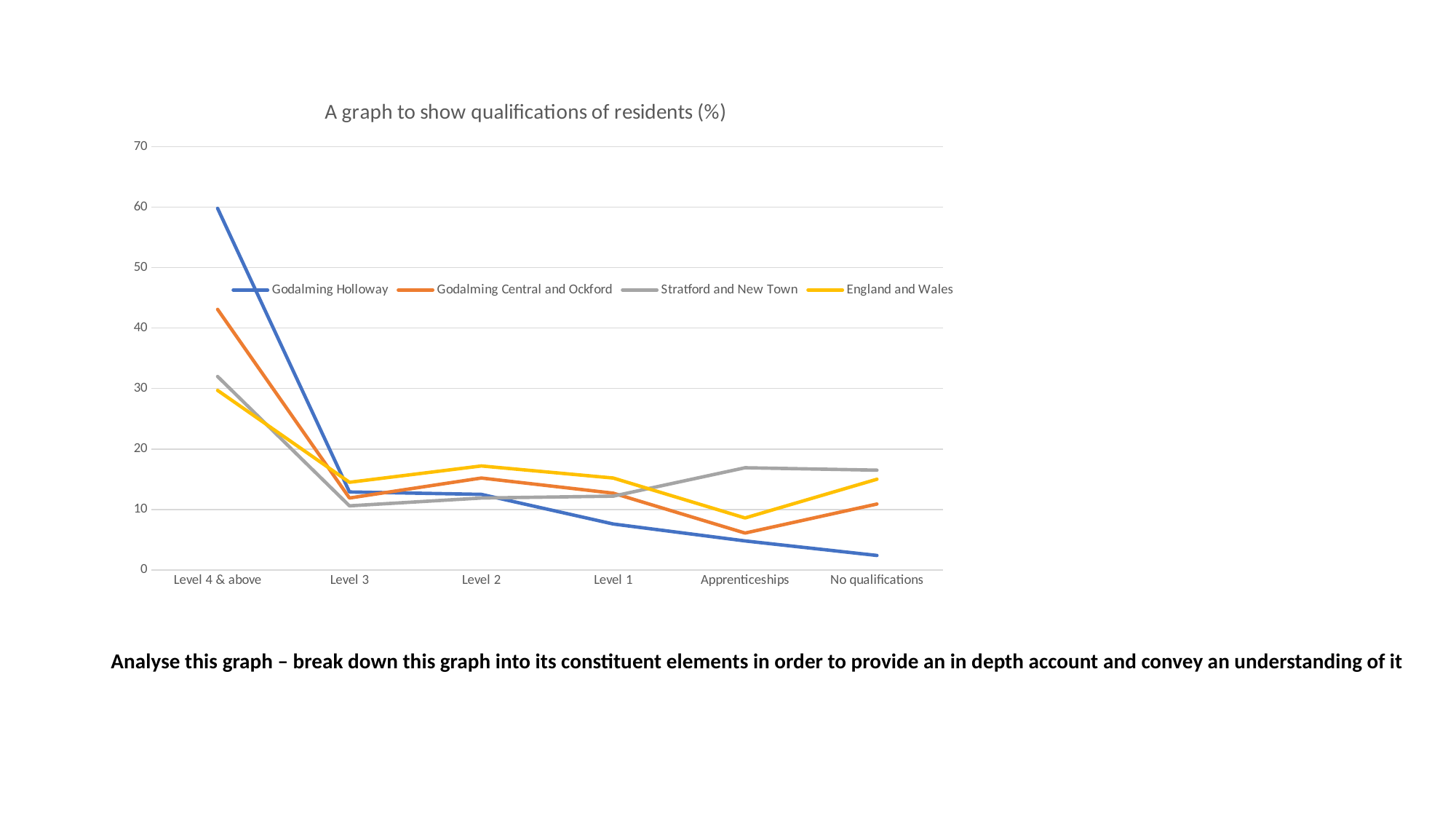
Which series has the highest value for Apprenticeships? Stratford and New Town Is the value for Stratford and New Town at Apprenticeships greater or less than 10? greater Is the value for Godalming Central and Ockford at Apprenticeships greater or less than 10? less Which series has the lowest value for No qualifications? Godalming Holloway How many qualification categories are shown on the x axis? 6 What is the title of the chart? A graph to show qualifications of residents (%) Which series has the highest value for Level 4 & above? Godalming Holloway How many series does the legend list? 4 At Level 4 & above, which is larger: Godalming Central and Ockford or Stratford and New Town? Godalming Central and Ockford What kind of chart is shown on the slide? line chart Does the Godalming Holloway line rise or fall from Level 4 & above to No qualifications? fall Is the value for Godalming Holloway at Level 4 & above greater or less than 50? greater